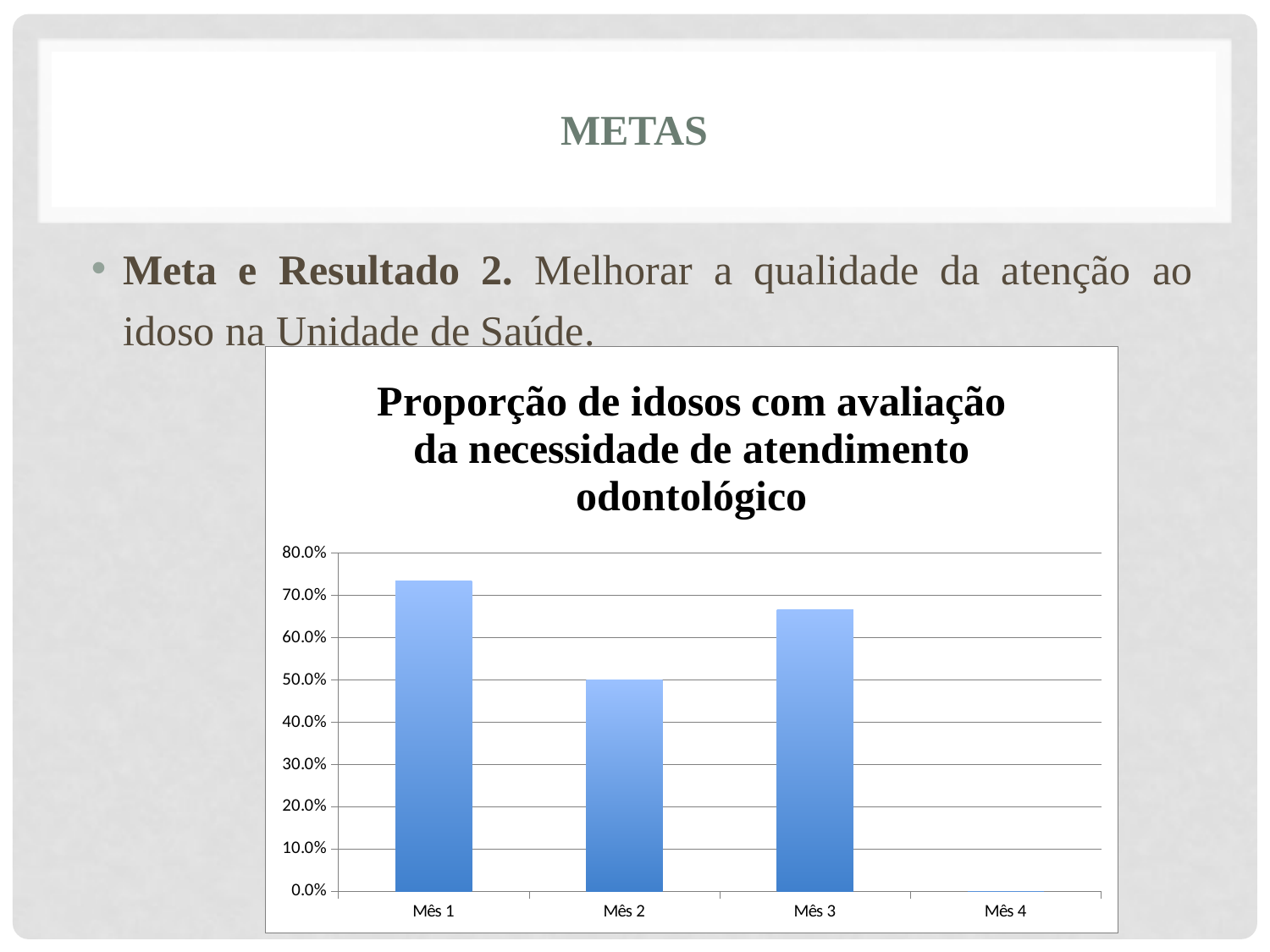
Is the value for Mês 3 greater or less than 60.0%? greater Does the value rise or fall from Mês 1 to Mês 2? fall Which month has the lowest proportion in the chart? Mês 4 What kind of chart is shown on the slide? bar chart What is the value for Mês 2 in the chart? 50.0% Is the value for Mês 1 greater or less than 70.0%? greater What is the title of the chart? Proporção de idosos com avaliação da necessidade de atendimento odontológico Is the value for Mês 3 greater or less than 70.0%? less Which is larger, the value for Mês 1 or the value for Mês 3? Mês 1 Which month has the highest proportion in the chart? Mês 1 How many categories are shown on the x axis of the chart? 4 Which is larger, the value for Mês 2 or the value for Mês 3? Mês 3